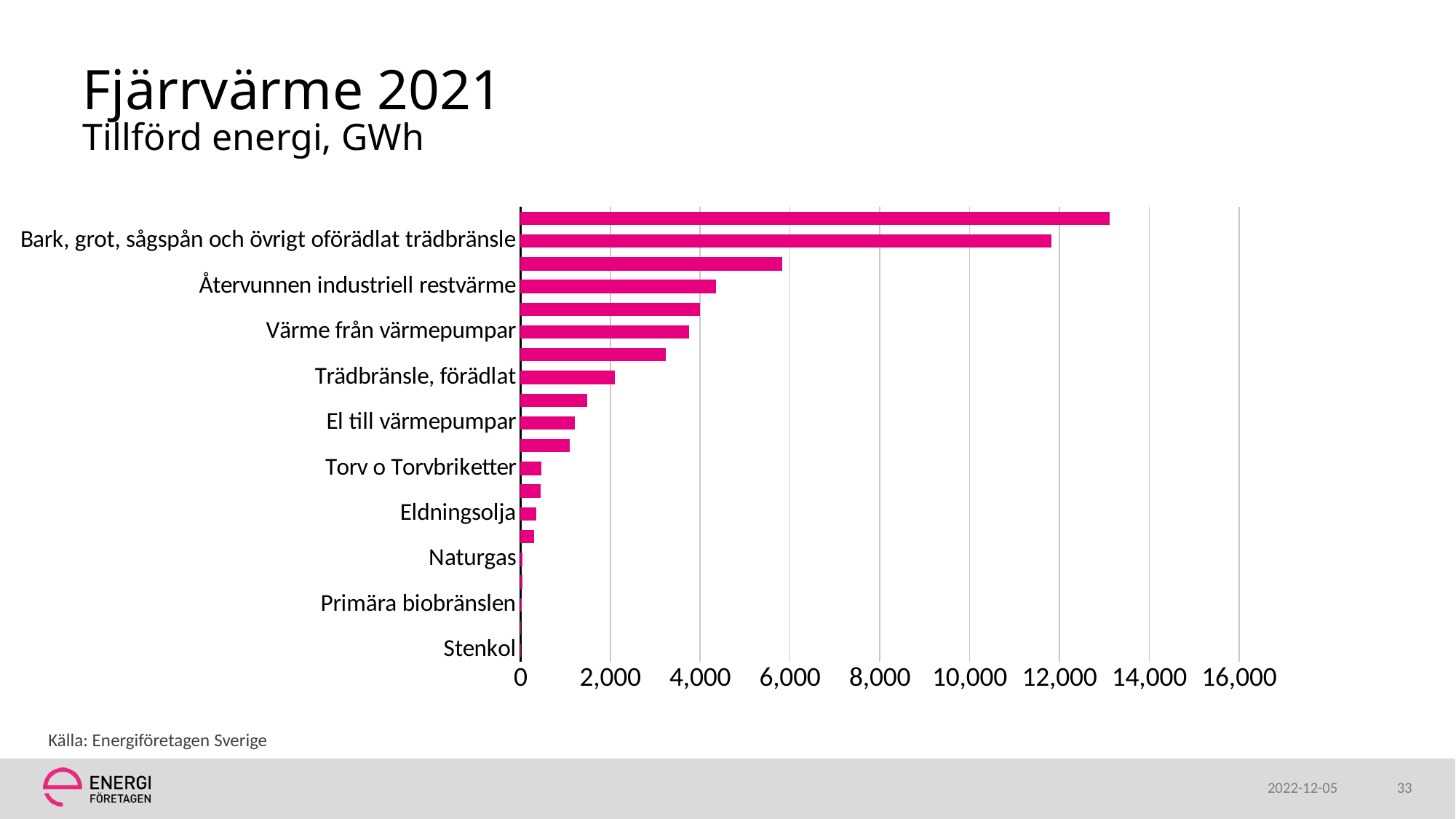
What kind of chart is shown on the slide? bar chart Is the value for Bark, grot, sågspån och övrigt oförädlat trädbränsle greater or less than 10,000? greater Which is larger, the value for Återvunnen industriell restvärme or the value for Trädbränsle, förädlat? Återvunnen industriell restvärme Is the value for Återvunnen industriell restvärme greater or less than 6,000? less What is the title of the chart on the slide? Fjärrvärme 2021 Is the value for Trädbränsle, förädlat greater or less than 4,000? less Which of the labelled categories has the highest value? Bark, grot, sågspån och övrigt oförädlat trädbränsle In what unit is the supplied energy (tillförd energi) shown in the chart? GWh Which is larger, the value for Värme från värmepumpar or the value for El till värmepumpar? Värme från värmepumpar